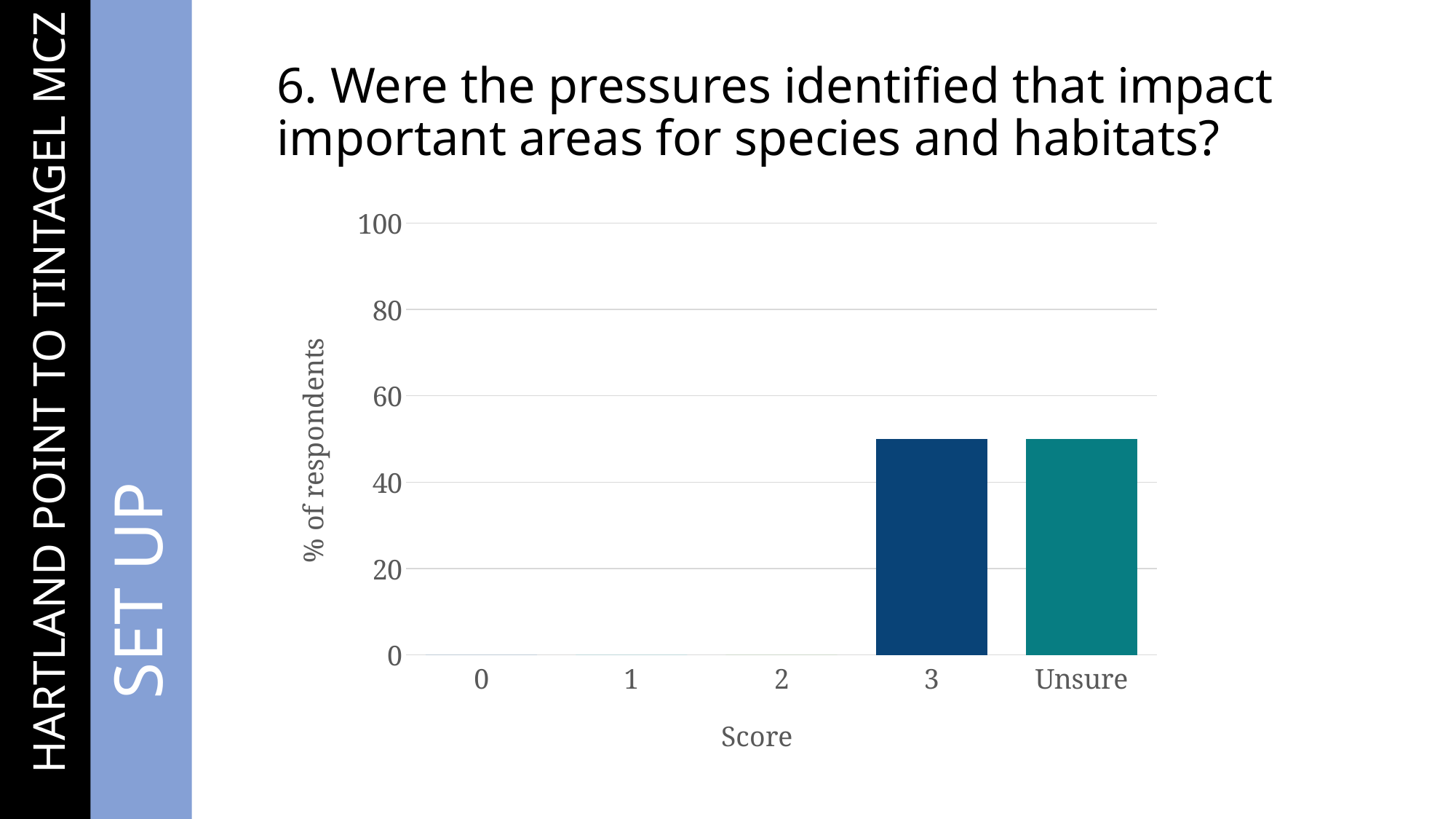
What is the label of the x axis? Score Is the value for score 3 greater or less than 60? less Is the value for score 2 greater or less than 20? less Is the value for score 0 greater or less than 20? less How many score categories are shown on the x axis? 5 Which score categories have no bar shown (zero respondents)? 0, 1 and 2 What is the highest value shown on the y axis? 100 What kind of chart is shown on the slide? bar chart What is the label of the y axis? % of respondents